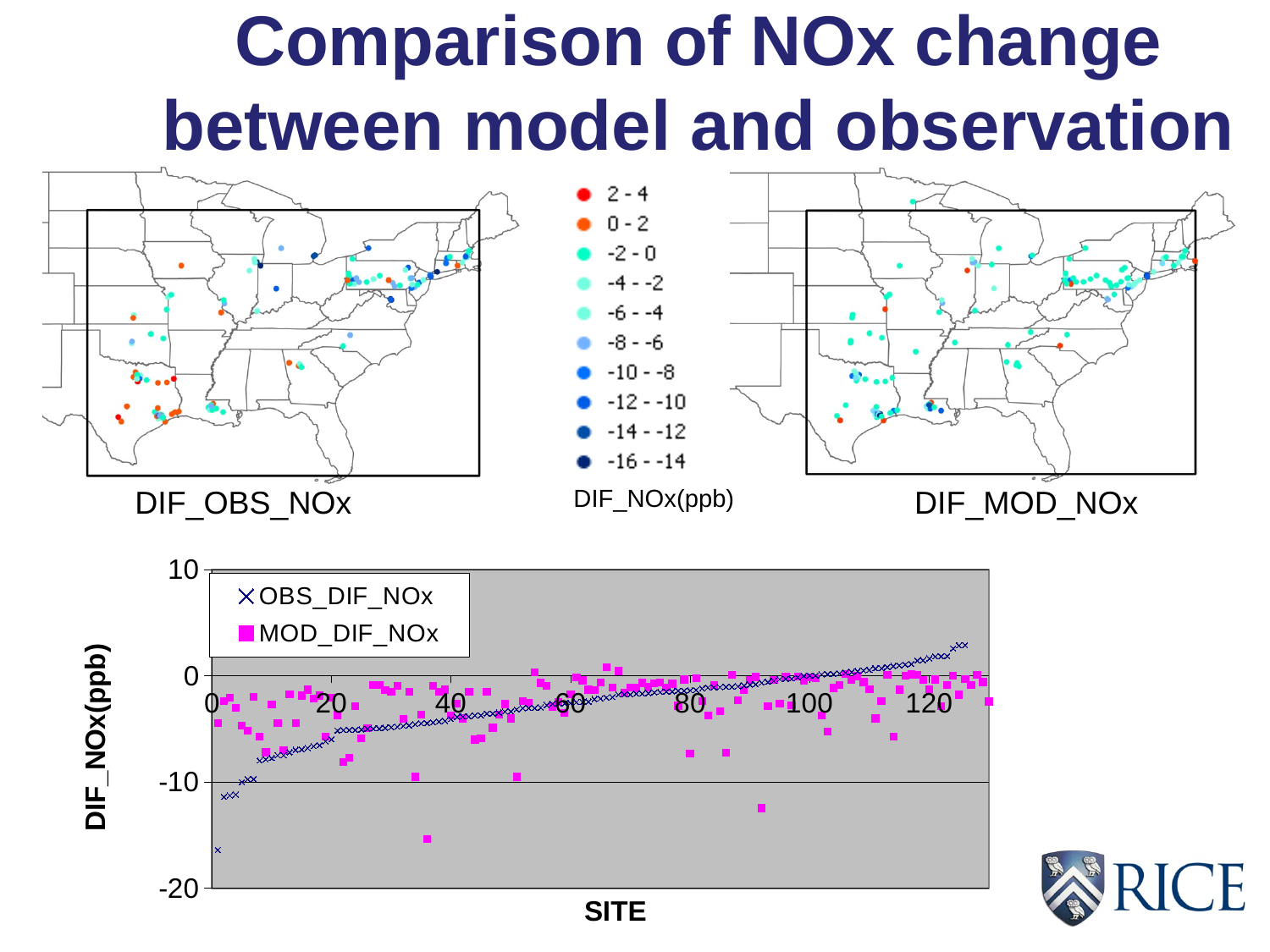
In the bottom chart, is the lowest MOD_DIF_NOx value greater or less than -10? less In the bottom chart, which series is drawn with magenta square markers? MOD_DIF_NOx In the bottom chart, how many series does the legend list? 2 In the bottom chart, what kind of chart is it? scatter chart In the bottom chart, what is the label of the y axis? DIF_NOx(ppb) In the map on the left, what is its title? DIF_OBS_NOx In the bottom chart, is the highest OBS_DIF_NOx value greater or less than 0? greater In the bottom chart, do the OBS_DIF_NOx values rise or fall as SITE increases along the x axis? rise In the map legend labelled DIF_NOx(ppb), how many value ranges are listed? 10 In the bottom chart, is the lowest OBS_DIF_NOx value greater or less than -10? less